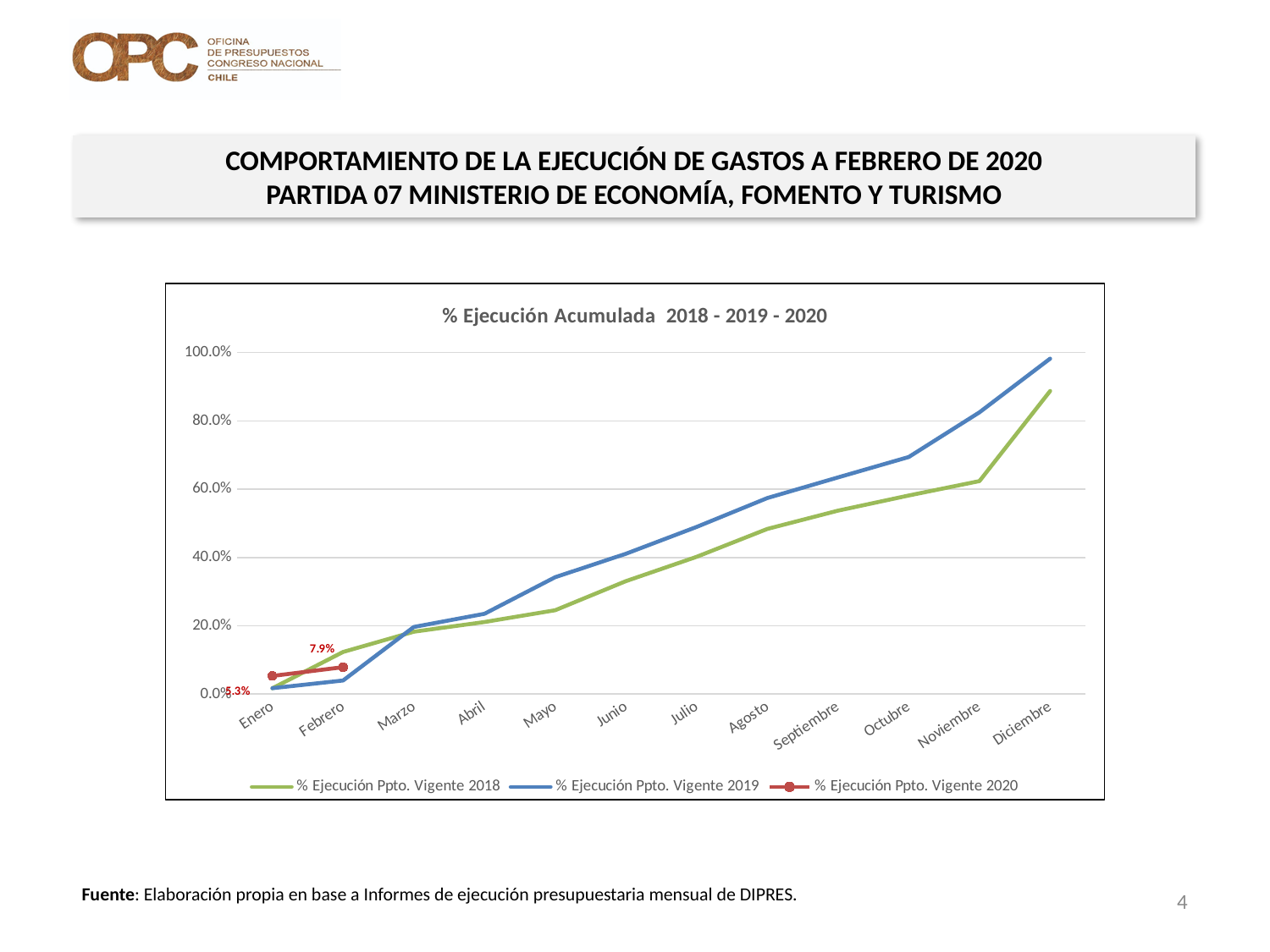
What is the difference between the Febrero and Enero values of the % Ejecución Ppto. Vigente 2020 series? 2.6% What is the value for Febrero in the % Ejecución Ppto. Vigente 2020 series? 7.9% Do the values of the % Ejecución Ppto. Vigente 2019 series rise or fall from Enero to Diciembre? rise Which series has the higher value in Diciembre, % Ejecución Ppto. Vigente 2018 or % Ejecución Ppto. Vigente 2019? % Ejecución Ppto. Vigente 2019 How many months are shown on the x axis? 12 What kind of chart is shown on the slide? line chart Is the value for Mayo in the % Ejecución Ppto. Vigente 2019 series greater or less than 40.0%? less Is the value for Diciembre in the % Ejecución Ppto. Vigente 2019 series greater or less than 80.0%? greater Is the value for Agosto in the % Ejecución Ppto. Vigente 2018 series greater or less than 60.0%? less What is the value for Enero in the % Ejecución Ppto. Vigente 2020 series? 5.3% How many series does the legend list? 3 What is the title of the chart? % Ejecución Acumulada 2018 - 2019 - 2020